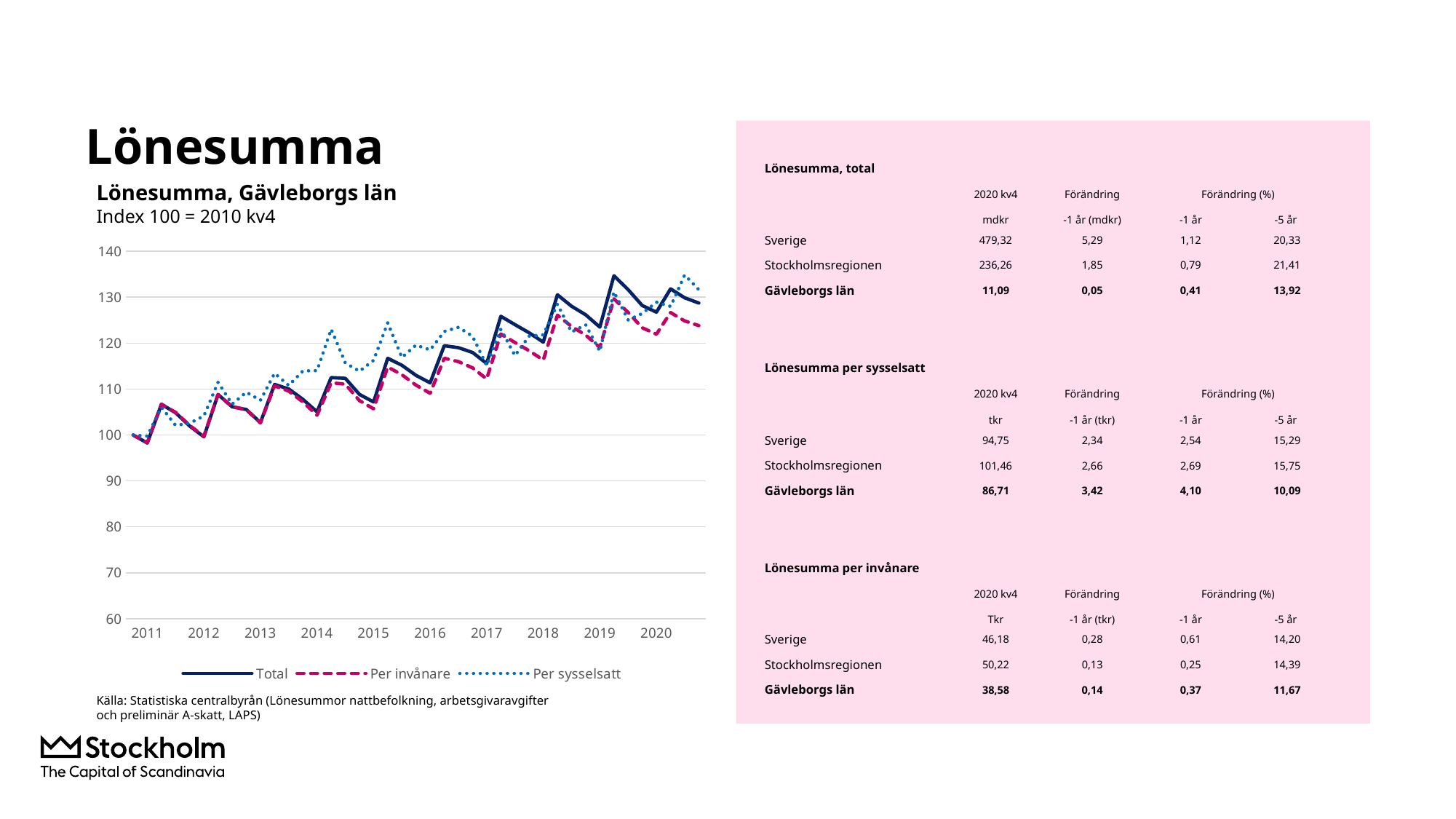
What kind of chart is shown on the slide? line chart Is the last value of the Per invånare series in 2020 greater or less than 130? less How many years are labelled on the x axis of the chart? 10 At the end of 2020, which series is higher: Per sysselsatt or Per invånare? Per sysselsatt What is the title of the chart? Lönesumma, Gävleborgs län How many series does the chart legend list? 3 Is the highest value of the Per sysselsatt series in 2020 greater or less than 130? greater Is the peak value of the Total series in 2019 greater or less than 130? greater Do the values of the Total series generally rise or fall from 2011 to 2020? rise What are the three series named in the chart legend? Total, Per invånare, Per sysselsatt Which series has the lowest value at the end of 2020? Per invånare